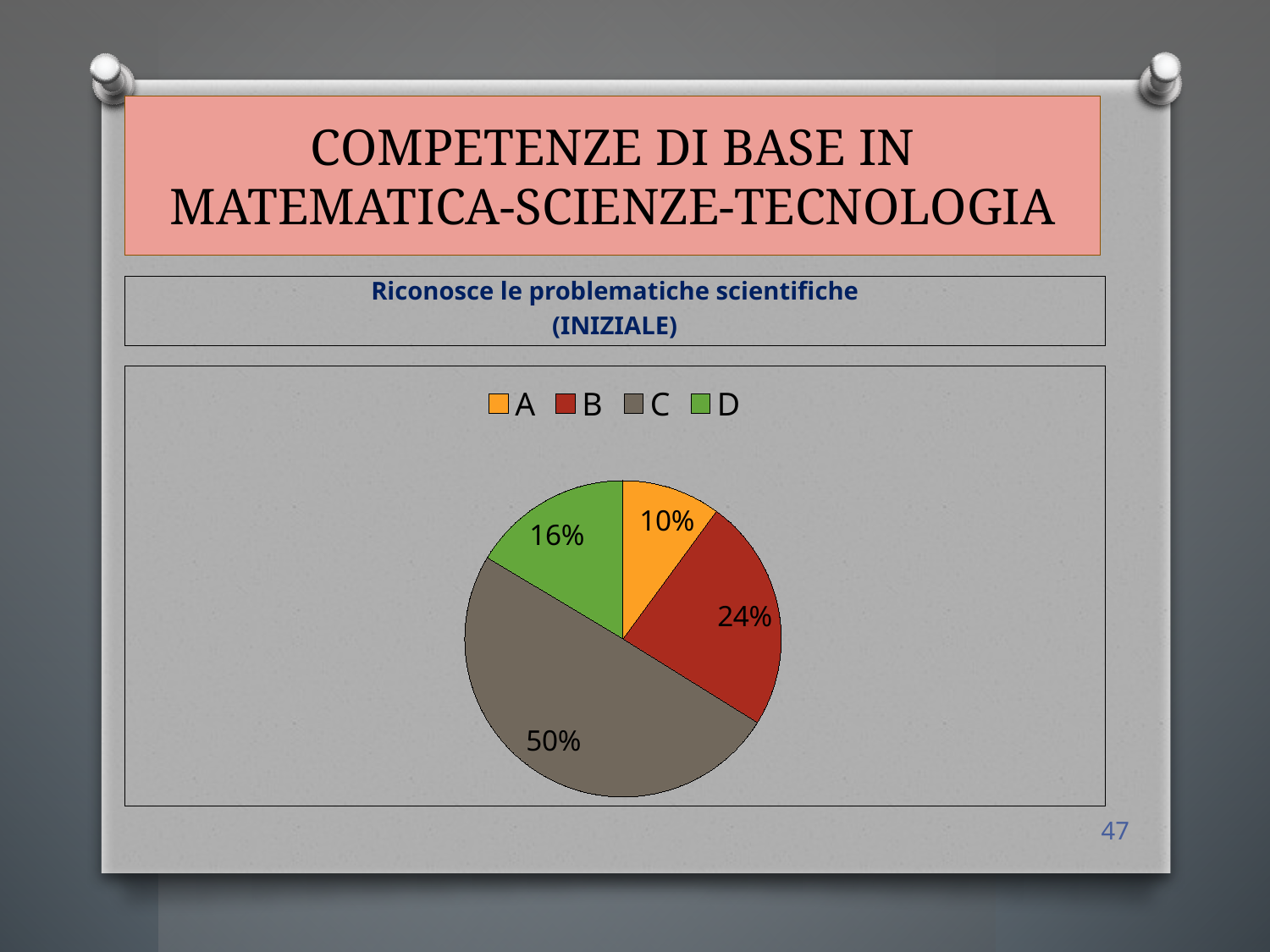
Which category has the largest slice of the pie? C Which category has the smallest slice of the pie? A What share of the pie does category A have? 10% What share of the pie does category D have? 16% What share of the pie does category C have? 50% What kind of chart is shown on the slide? pie chart Which is larger, the share of category B or the share of category D? B How many categories does the pie chart show? 4 What is the title shown above the chart? Riconosce le problematiche scientifiche (INIZIALE) What colour is the slice for category D? green What is the difference between the shares of category C and category B? 26%